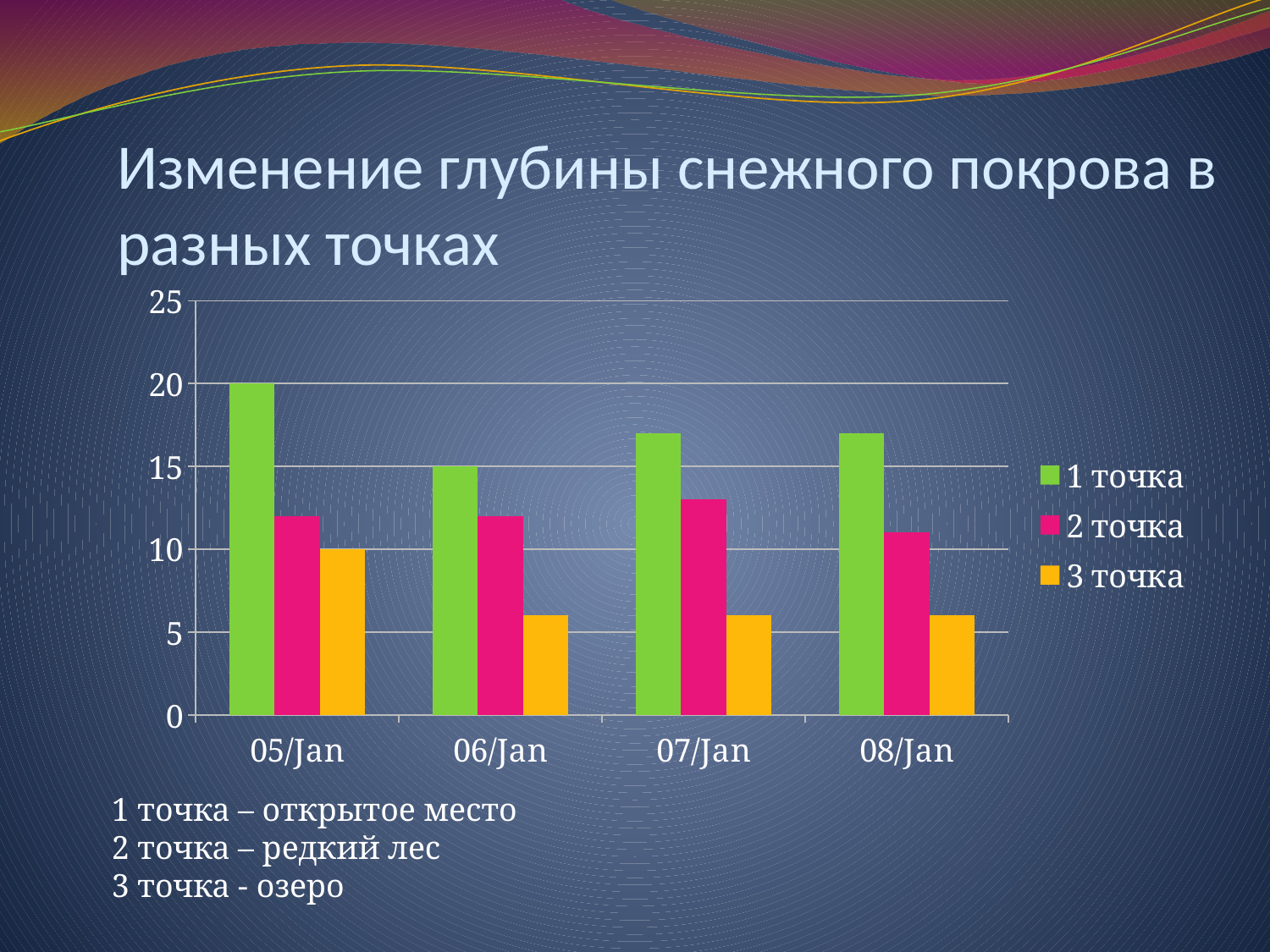
What is the value for 1 точка on 06/Jan? 15 How many series does the legend list? 3 Which is larger on 08/Jan: 1 точка or 2 точка? 1 точка What is the value for 1 точка on 05/Jan? 20 Is the value for 3 точка on 08/Jan greater or less than 10? less Which series has the lowest value on 06/Jan? 3 точка What kind of chart is shown on the slide? bar chart Is the value for 2 точка on 07/Jan greater or less than 10? greater What is the value for 3 точка on 05/Jan? 10 Is the value for 1 точка on 07/Jan greater or less than 15? greater How many dates are shown on the x axis? 4 On which date is the value for 1 точка highest? 05/Jan